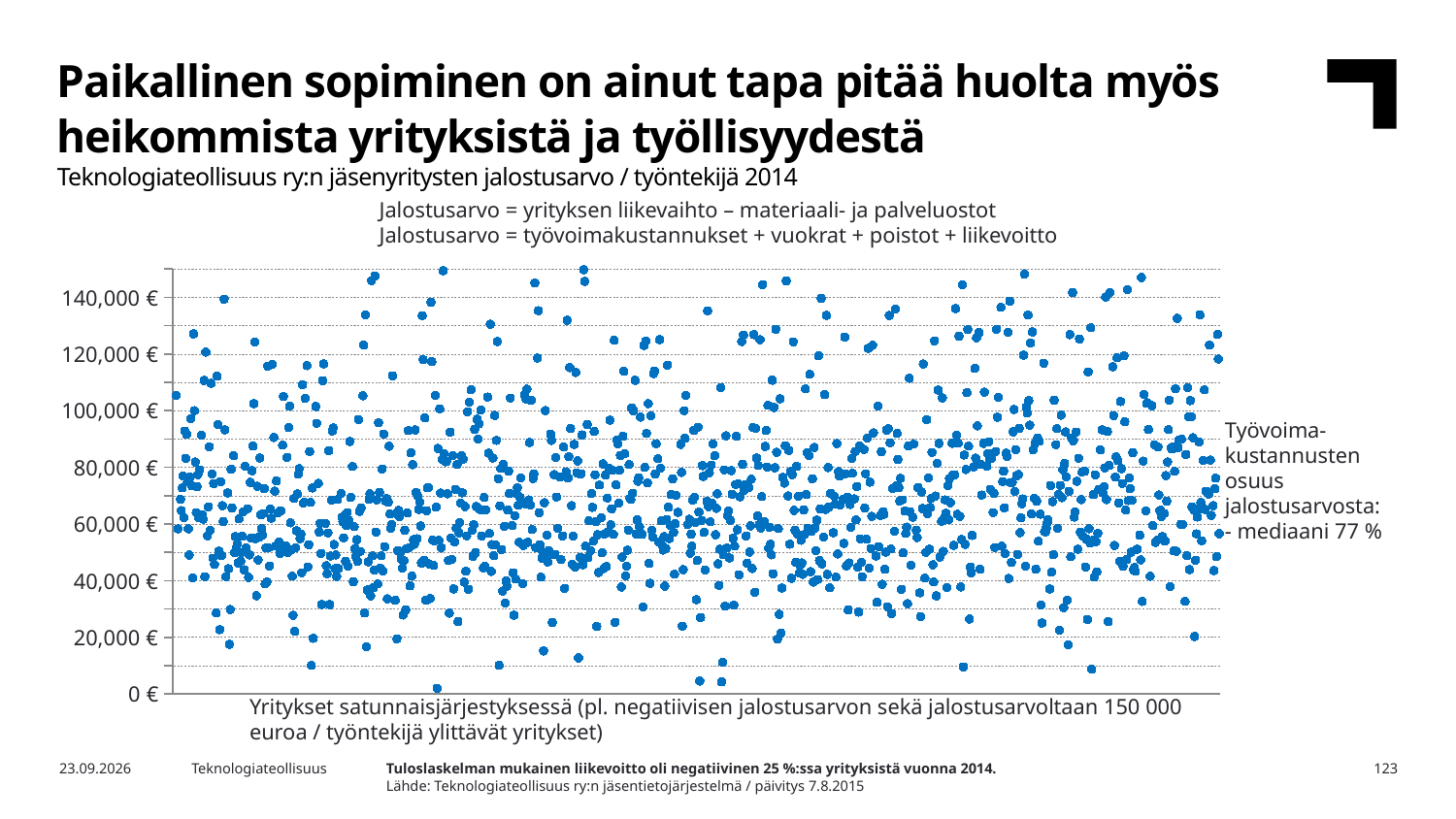
In what order are the companies arranged along the x axis, according to the axis note? satunnaisjärjestyksessä (random order) Which year's value added per employee does the chart show? 2014 What is the highest value labelled on the vertical axis of the chart? 140,000 € Above what value added per employee were companies excluded from the chart, according to the x-axis note? 150 000 euroa / työntekijä What kind of chart is shown on the slide? scatter chart What colour are the data points in the chart? blue What is the lowest value labelled on the vertical axis of the chart? 0 € What is the interval between consecutive tick labels on the vertical axis? 20,000 € According to the annotation on the chart, what is the median share of labour costs (työvoimakustannusten osuus) of value added? 77 %